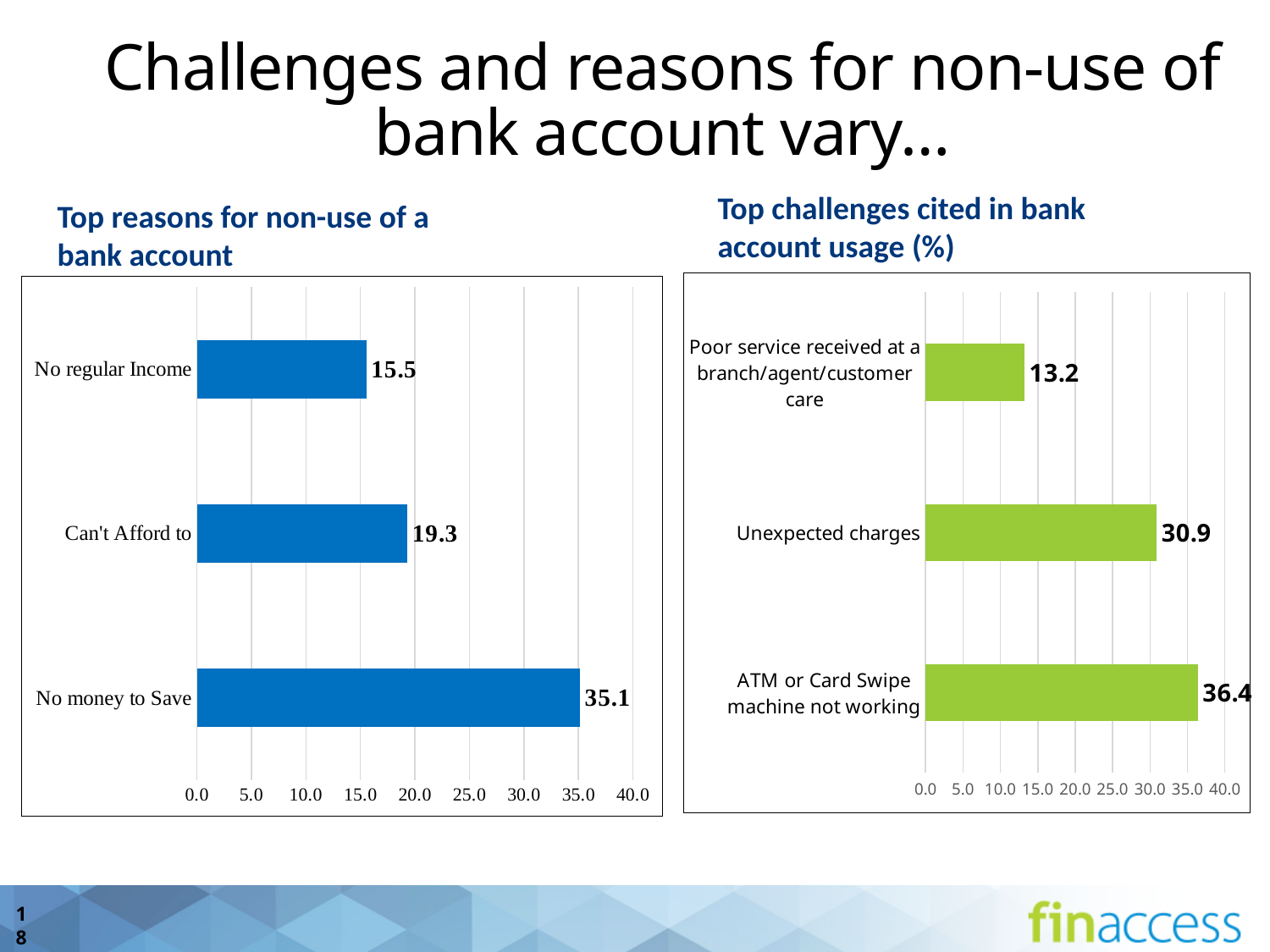
In the 'Top reasons for non-use of a bank account' chart, what is the difference between No money to Save and Can't Afford to? 15.8 In the 'Top challenges cited in bank account usage (%)' chart, what is the value for ATM or Card Swipe machine not working? 36.4 In the 'Top challenges cited in bank account usage (%)' chart, what is the difference between ATM or Card Swipe machine not working and Poor service received at a branch/agent/customer care? 23.2 What kind of chart is the 'Top challenges cited in bank account usage (%)' chart? Bar chart In the 'Top challenges cited in bank account usage (%)' chart, what is the value for Unexpected charges? 30.9 In the 'Top reasons for non-use of a bank account' chart, what is the value for No regular Income? 15.5 In the 'Top challenges cited in bank account usage (%)' chart, which category has the lowest value? Poor service received at a branch/agent/customer care In the 'Top reasons for non-use of a bank account' chart, what is the value for Can't Afford to? 19.3 In the 'Top reasons for non-use of a bank account' chart, which category has the lowest value? No regular Income In the 'Top reasons for non-use of a bank account' chart, how many categories are shown? 3 In the 'Top challenges cited in bank account usage (%)' chart, which is larger: Unexpected charges or Poor service received at a branch/agent/customer care? Unexpected charges In the 'Top reasons for non-use of a bank account' chart, which category has the highest value? No money to Save